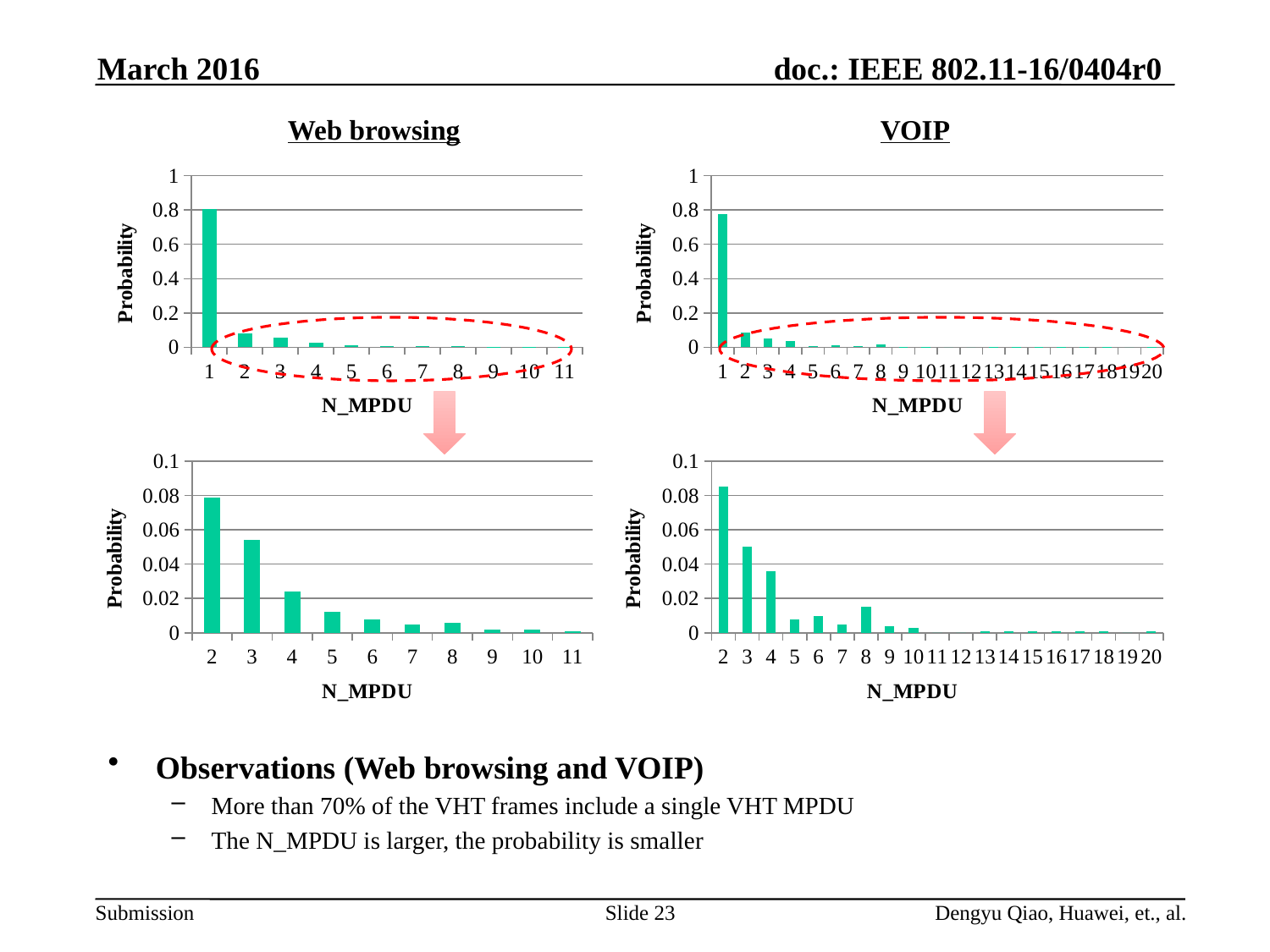
In the bottom-right VOIP chart, is the probability for N_MPDU = 2 greater or less than 0.08? greater In the bottom-right VOIP chart, which has the higher probability, N_MPDU = 7 or N_MPDU = 8? N_MPDU = 8 In the top-right VOIP chart, is the probability for N_MPDU = 1 greater or less than 0.6? greater In the bottom-left Web browsing chart, do the probabilities generally rise or fall as N_MPDU increases? fall In the top-left Web browsing chart, is the probability for N_MPDU = 1 greater or less than 0.6? greater What kind of chart is the top-left Web browsing chart? bar chart In the top-right VOIP chart, how many N_MPDU categories are shown on the x axis? 20 In the bottom-left Web browsing chart, which N_MPDU value has the highest probability? 2 In the top-left Web browsing chart, how many N_MPDU categories are shown on the x axis? 11